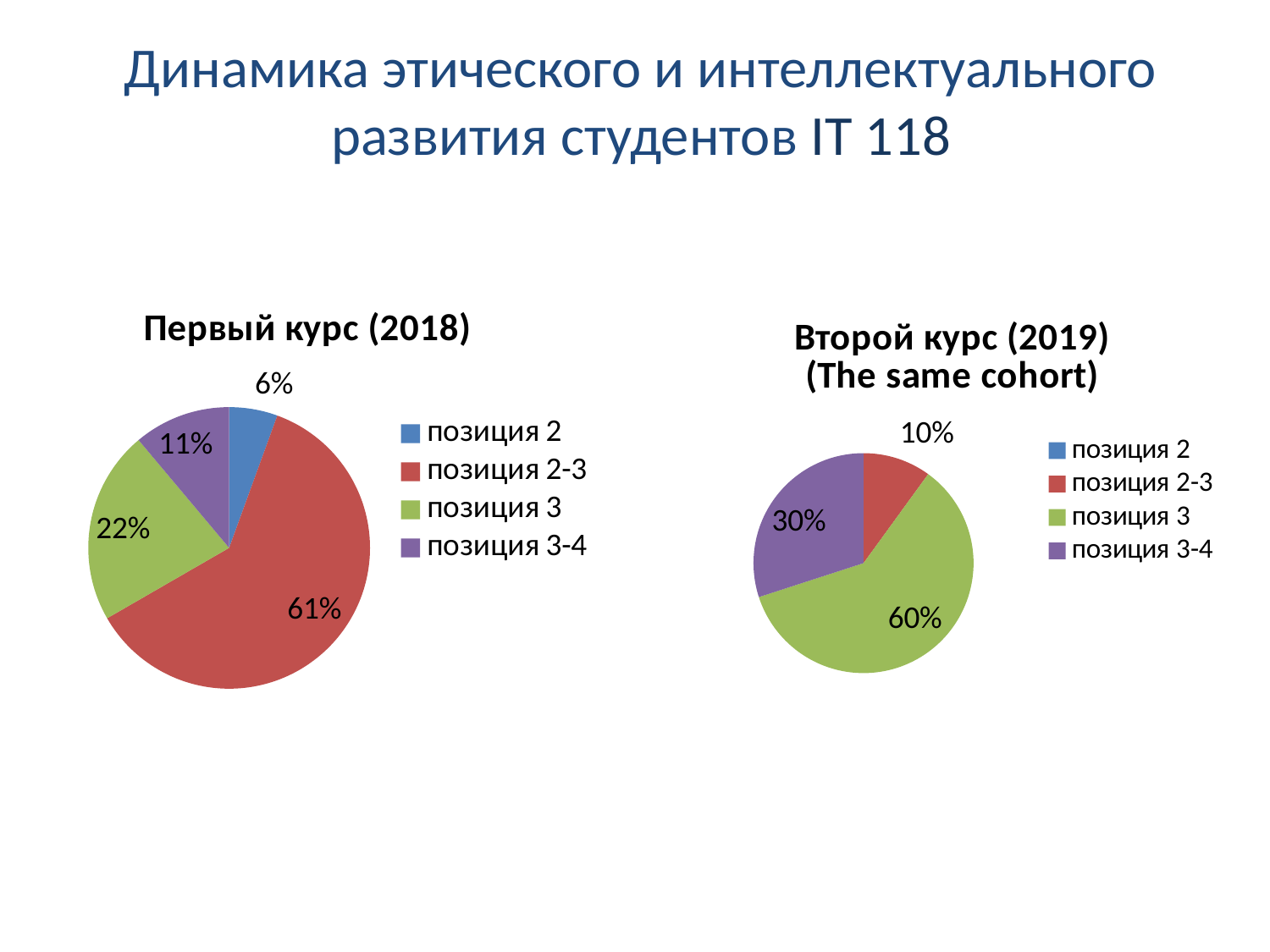
In the "Второй курс (2019)" chart, what share does "позиция 2-3" have? 10% In the "Первый курс (2018)" chart, what is the difference between the shares of "позиция 3" and "позиция 3-4"? 11% Which is larger: "позиция 3-4" in the "Первый курс (2018)" chart or "позиция 3-4" in the "Второй курс (2019)" chart? Второй курс (2019) In the "Первый курс (2018)" chart, which category has the largest slice? позиция 2-3 In the "Первый курс (2018)" chart, what share does "позиция 2-3" have? 61% In the "Второй курс (2019)" chart, which category has the largest slice? позиция 3 What type of chart is used for "Первый курс (2018)"? Pie chart In the "Первый курс (2018)" chart, what share does "позиция 3" have? 22% In the "Второй курс (2019)" chart, what share does "позиция 3" have? 60% In the "Первый курс (2018)" chart, which category has the smallest slice? позиция 2 In the "Первый курс (2018)" chart, what share does "позиция 2" have? 6% In the "Второй курс (2019)" chart, what share does "позиция 3-4" have? 30%